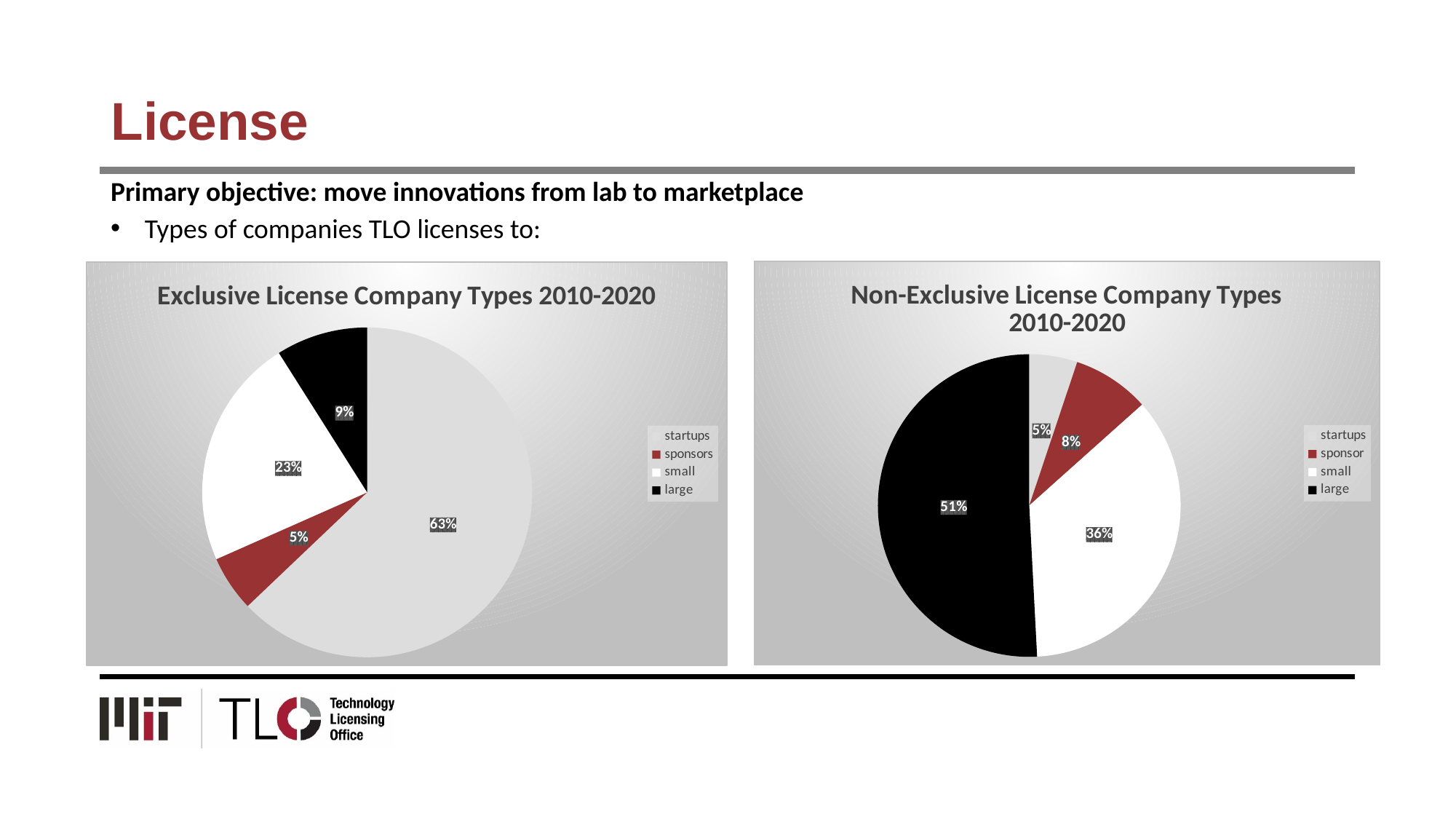
In the 'Non-Exclusive License Company Types 2010-2020' chart, what is the difference between the large and small company shares? 15% In the 'Non-Exclusive License Company Types 2010-2020' chart, which company type has the largest share? large In the 'Exclusive License Company Types 2010-2020' chart, what share do startups have? 63% In the 'Exclusive License Company Types 2010-2020' chart, what share do small companies have? 23% In the 'Exclusive License Company Types 2010-2020' chart, which company type has the smallest share? sponsors In the 'Non-Exclusive License Company Types 2010-2020' chart, what share do large companies have? 51% In the 'Exclusive License Company Types 2010-2020' chart, which company type has the largest share? startups In the 'Exclusive License Company Types 2010-2020' chart, what share do large companies have? 9% In the 'Non-Exclusive License Company Types 2010-2020' chart, what share do sponsors have? 8% What kind of chart is the 'Exclusive License Company Types 2010-2020' chart? pie chart How many categories does the legend of the 'Non-Exclusive License Company Types 2010-2020' chart list? 4 In the 'Non-Exclusive License Company Types 2010-2020' chart, what share do small companies have? 36%